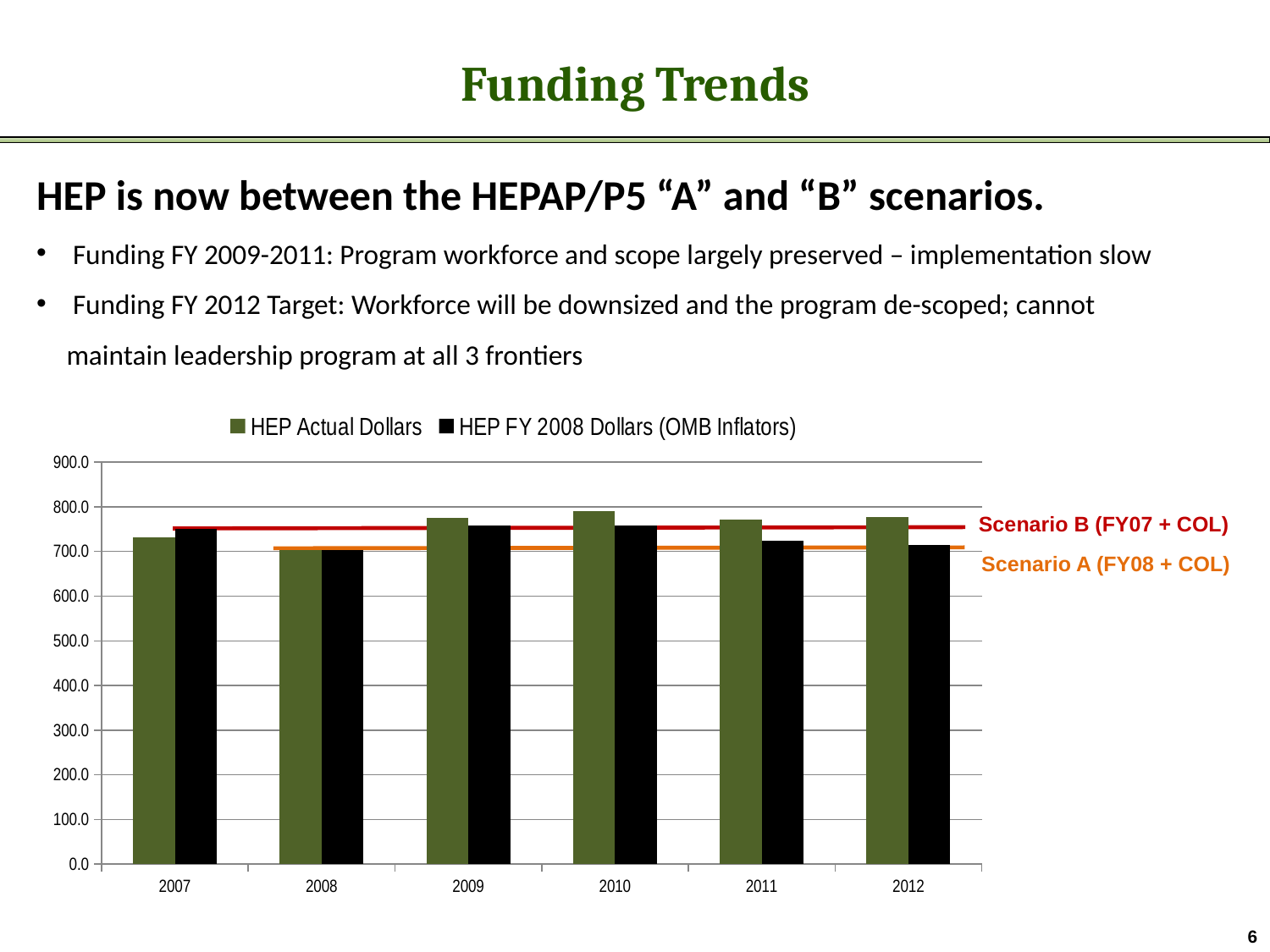
Is the HEP FY 2008 Dollars (OMB Inflators) value for 2011 greater or less than 700.0? greater For 2007, which is larger: HEP Actual Dollars or HEP FY 2008 Dollars (OMB Inflators)? HEP FY 2008 Dollars (OMB Inflators) For 2012, which is larger: HEP Actual Dollars or HEP FY 2008 Dollars (OMB Inflators)? HEP Actual Dollars Which year has the lowest HEP Actual Dollars bar? 2008 What kind of chart is shown on the slide? bar chart What label is given to the red horizontal line on the chart? Scenario B (FY07 + COL) Which series is shown in black in the chart? HEP FY 2008 Dollars (OMB Inflators) How many years are shown on the x axis of the chart? 6 How many series does the chart legend list? 2 Is the HEP Actual Dollars value for 2009 greater or less than 700.0? greater Is the HEP Actual Dollars value for 2010 greater or less than 800.0? less Which year has the highest HEP Actual Dollars bar? 2010